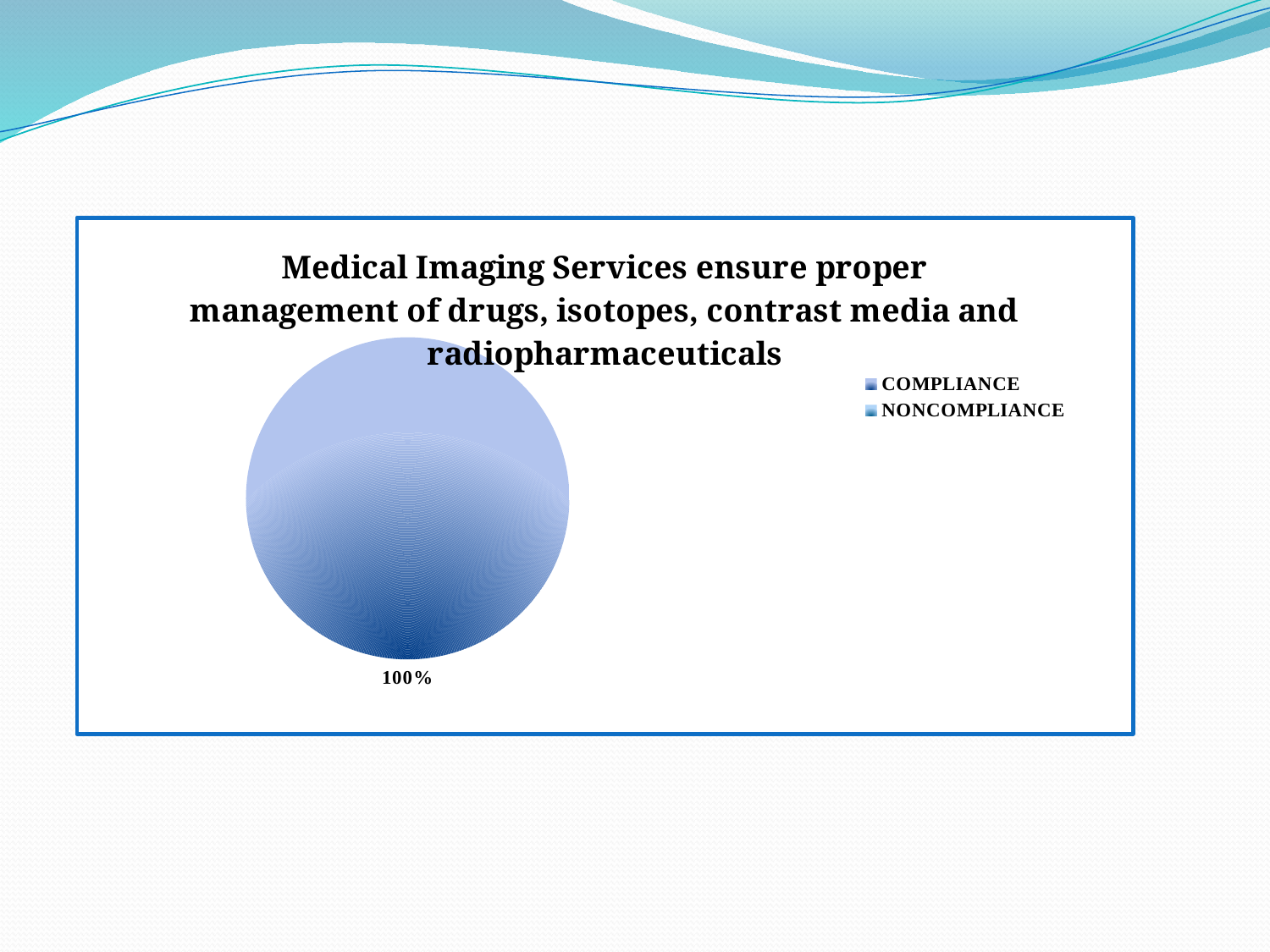
How many slices are visible in the pie chart? 1 What share of the pie does the single visible slice take up? 100% What is the title of the chart? Medical Imaging Services ensure proper management of drugs, isotopes, contrast media and radiopharmaceuticals What kind of chart is shown on the slide? pie chart Is the share shown by the data label on the pie greater or less than 50%? greater Which category has the larger share of the pie, COMPLIANCE or NONCOMPLIANCE? COMPLIANCE What are the two categories listed in the legend? COMPLIANCE and NONCOMPLIANCE How many entries does the chart's legend list? 2 What percentage value is printed as a data label on the pie chart? 100%